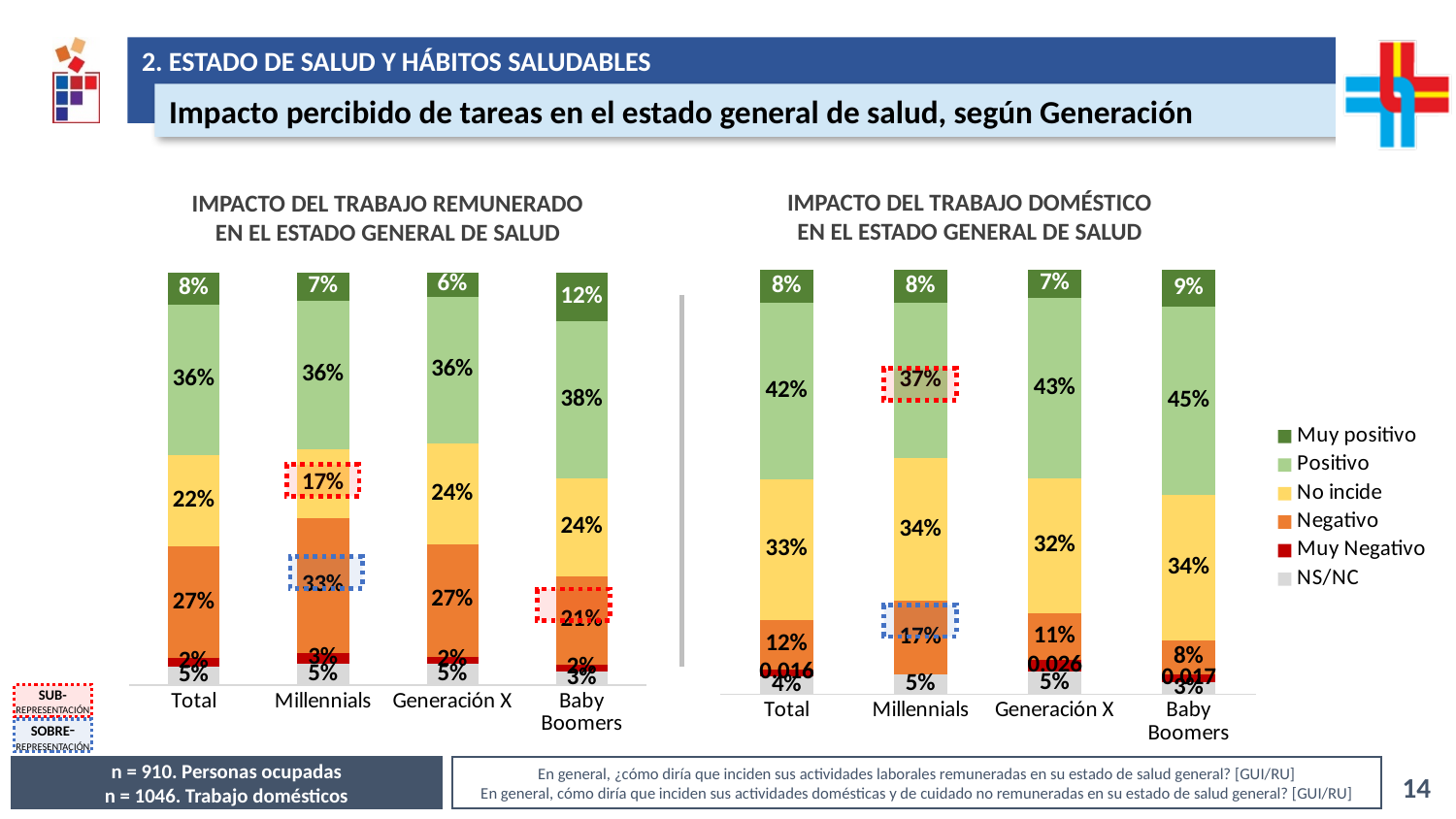
In the chart titled 'IMPACTO DEL TRABAJO DOMÉSTICO EN EL ESTADO GENERAL DE SALUD', is the 'Negativo' value larger for Millennials or for Generación X? Millennials What kind of chart is the chart titled 'IMPACTO DEL TRABAJO DOMÉSTICO EN EL ESTADO GENERAL DE SALUD'? Stacked bar chart In the chart titled 'IMPACTO DEL TRABAJO REMUNERADO EN EL ESTADO GENERAL DE SALUD', what is the difference between the 'No incide' values for Generación X and Millennials? 7% In the chart titled 'IMPACTO DEL TRABAJO DOMÉSTICO EN EL ESTADO GENERAL DE SALUD', what is the difference between the 'Positivo' values for Baby Boomers and Total? 3% In the chart titled 'IMPACTO DEL TRABAJO REMUNERADO EN EL ESTADO GENERAL DE SALUD', what is the 'Positivo' value for Baby Boomers? 38% In the chart titled 'IMPACTO DEL TRABAJO DOMÉSTICO EN EL ESTADO GENERAL DE SALUD', what is the 'Negativo' value for Total? 12% In the chart titled 'IMPACTO DEL TRABAJO REMUNERADO EN EL ESTADO GENERAL DE SALUD', what is the 'Negativo' value for Millennials? 33% How many series does the legend on the slide list? 6 How many categories are shown on the x axis of the chart titled 'IMPACTO DEL TRABAJO REMUNERADO EN EL ESTADO GENERAL DE SALUD'? 4 In the chart titled 'IMPACTO DEL TRABAJO DOMÉSTICO EN EL ESTADO GENERAL DE SALUD', what is the 'Positivo' value for Generación X? 43% In the chart titled 'IMPACTO DEL TRABAJO REMUNERADO EN EL ESTADO GENERAL DE SALUD', which generation has the highest 'Muy positivo' value? Baby Boomers In the chart titled 'IMPACTO DEL TRABAJO DOMÉSTICO EN EL ESTADO GENERAL DE SALUD', which category has the lowest 'Negativo' value? Baby Boomers